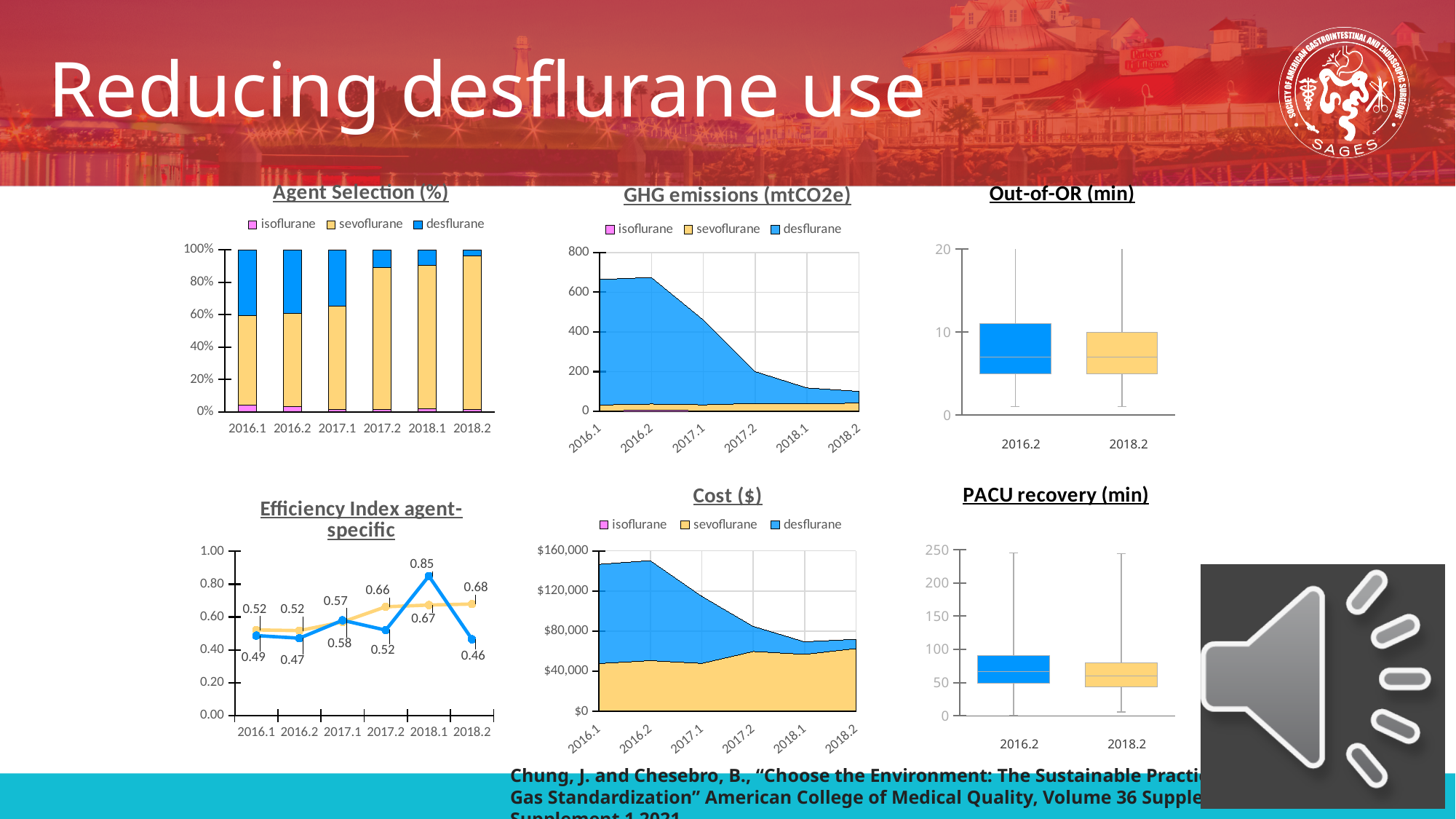
In the 'Efficiency Index agent-specific' chart, at which period does the blue line reach its highest value? 2018.1 In the 'GHG emissions (mtCO2e)' chart, do total emissions rise or fall from 2016.1 to 2018.2? fall In the 'Efficiency Index agent-specific' chart, what is the value of the blue line at 2018.1? 0.85 In the 'Cost ($)' chart, is the total cost at 2016.1 greater or less than $120,000? greater In the 'Efficiency Index agent-specific' chart, what is the value of the yellow line at 2018.2? 0.68 In the 'Efficiency Index agent-specific' chart, what is the difference between the blue line's values at 2018.1 and 2018.2? 0.39 In the 'Agent Selection (%)' chart, is the desflurane share in 2018.2 greater or less than 20%? less How many time periods are shown on the x axis of the 'GHG emissions (mtCO2e)' chart? 6 How many series does the legend of the 'Agent Selection (%)' chart list? 3 What kind of chart is the 'Agent Selection (%)' chart? bar chart In the 'GHG emissions (mtCO2e)' chart, is the total value at 2016.1 greater or less than 600? greater In the 'Efficiency Index agent-specific' chart, which line has the higher value at 2018.2, the blue line or the yellow line? yellow line